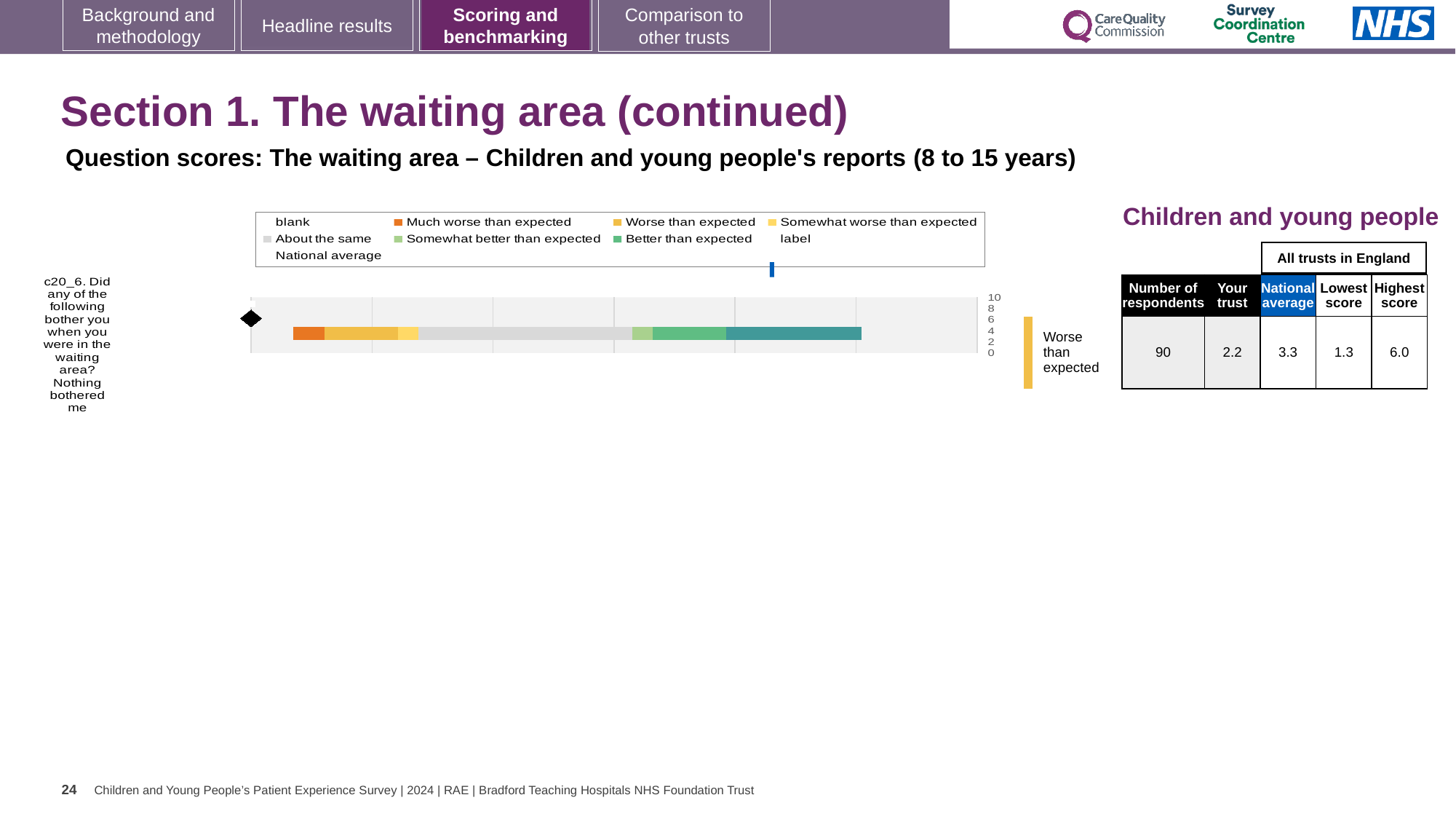
In the table to the right of the chart, how many respondents are listed? 90 How many question categories are plotted in the chart? 1 What kind of chart is shown on the slide? bar chart What is the difference between the national average (3.3) and the 'Your trust' score (2.2)? 1.1 In the table to the right of the chart, what is the highest score among all trusts in England? 6.0 What colour represents 'Much worse than expected' in the chart legend? orange In the table to the right of the chart, what is the national average score? 3.3 Which is larger, the 'Your trust' score or the national average? National average What benchmark label is shown beside the chart for question c20_6? Worse than expected How many entries does the chart's legend list? 9 In the table to the right of the chart, what is the 'Your trust' score for question c20_6? 2.2 In the table to the right of the chart, what is the lowest score among all trusts in England? 1.3